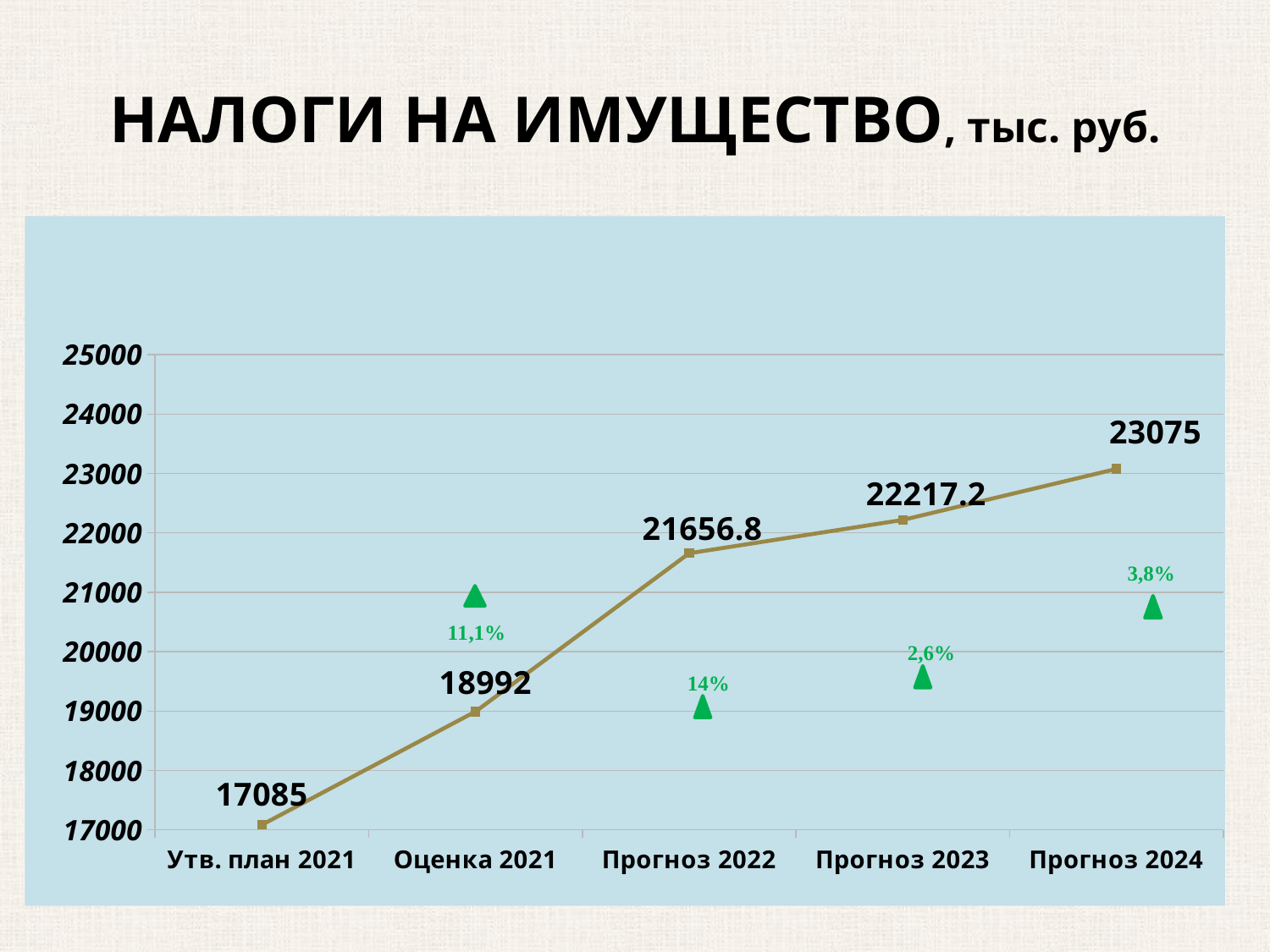
What kind of chart is shown on the slide? line chart What is the difference between the values for Прогноз 2024 and Прогноз 2023? 857.8 Which category has the highest value? Прогноз 2024 What is the value for Прогноз 2024? 23075 Which is larger, the value for Прогноз 2023 or the value for Оценка 2021? Прогноз 2023 Do the values rise or fall from Утв. план 2021 to Прогноз 2024? rise How many categories are shown on the x axis? 5 What is the value for Утв. план 2021? 17085 Which category has the lowest value? Утв. план 2021 What is the difference between the values for Оценка 2021 and Утв. план 2021? 1907 What is the value for Прогноз 2022? 21656.8 Is the value for Прогноз 2023 greater or less than 22000? greater